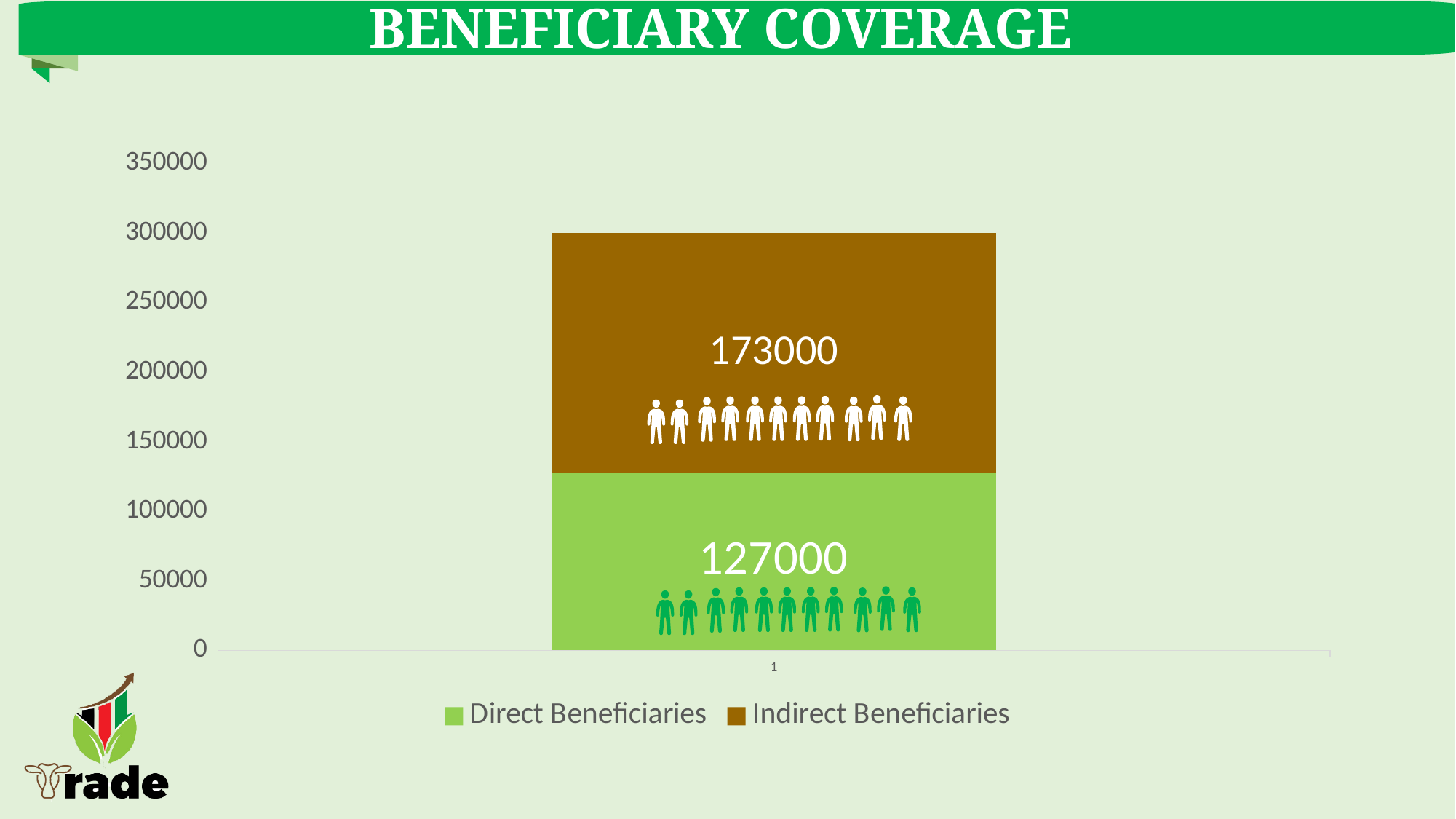
What is the value for Direct Beneficiaries? 127000 What is the value for Indirect Beneficiaries? 173000 What is the total of the stacked bar? 300000 How many bars are plotted in the chart? 1 What kind of chart is shown on the slide? Stacked bar chart What is the difference between the Indirect Beneficiaries value and the Direct Beneficiaries value? 46000 Is the value for Direct Beneficiaries greater or less than 150000? less What is the title of the slide containing the chart? BENEFICIARY COVERAGE Which colour represents Indirect Beneficiaries in the legend? Brown Which series has the larger value, Direct Beneficiaries or Indirect Beneficiaries? Indirect Beneficiaries How many series does the legend list? 2 Is the total height of the stacked bar greater or less than 250000? greater